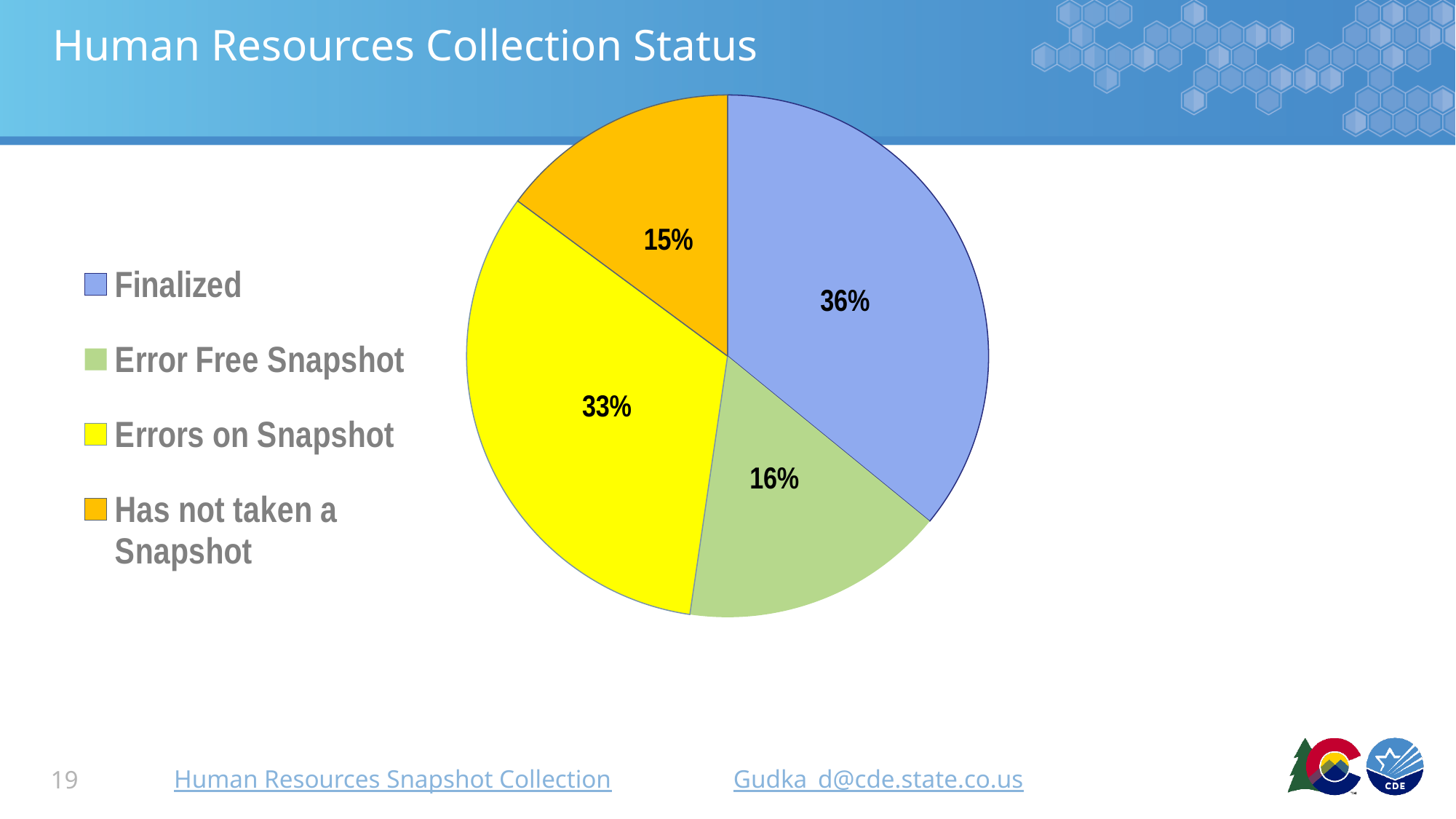
What percentage of the pie is Errors on Snapshot? 33% How many categories does the legend list? 4 What is the difference in percentage points between Finalized and Errors on Snapshot? 3% Which category has the smallest share of the pie? Has not taken a Snapshot Which is larger, Error Free Snapshot or Errors on Snapshot? Errors on Snapshot Which category has the largest share of the pie? Finalized What type of chart is shown on the slide? pie chart What is the title of the slide containing the chart? Human Resources Collection Status What percentage of the pie is Finalized? 36% What percentage of the pie is Has not taken a Snapshot? 15% What colour is the Errors on Snapshot slice? yellow What percentage of the pie is Error Free Snapshot? 16%